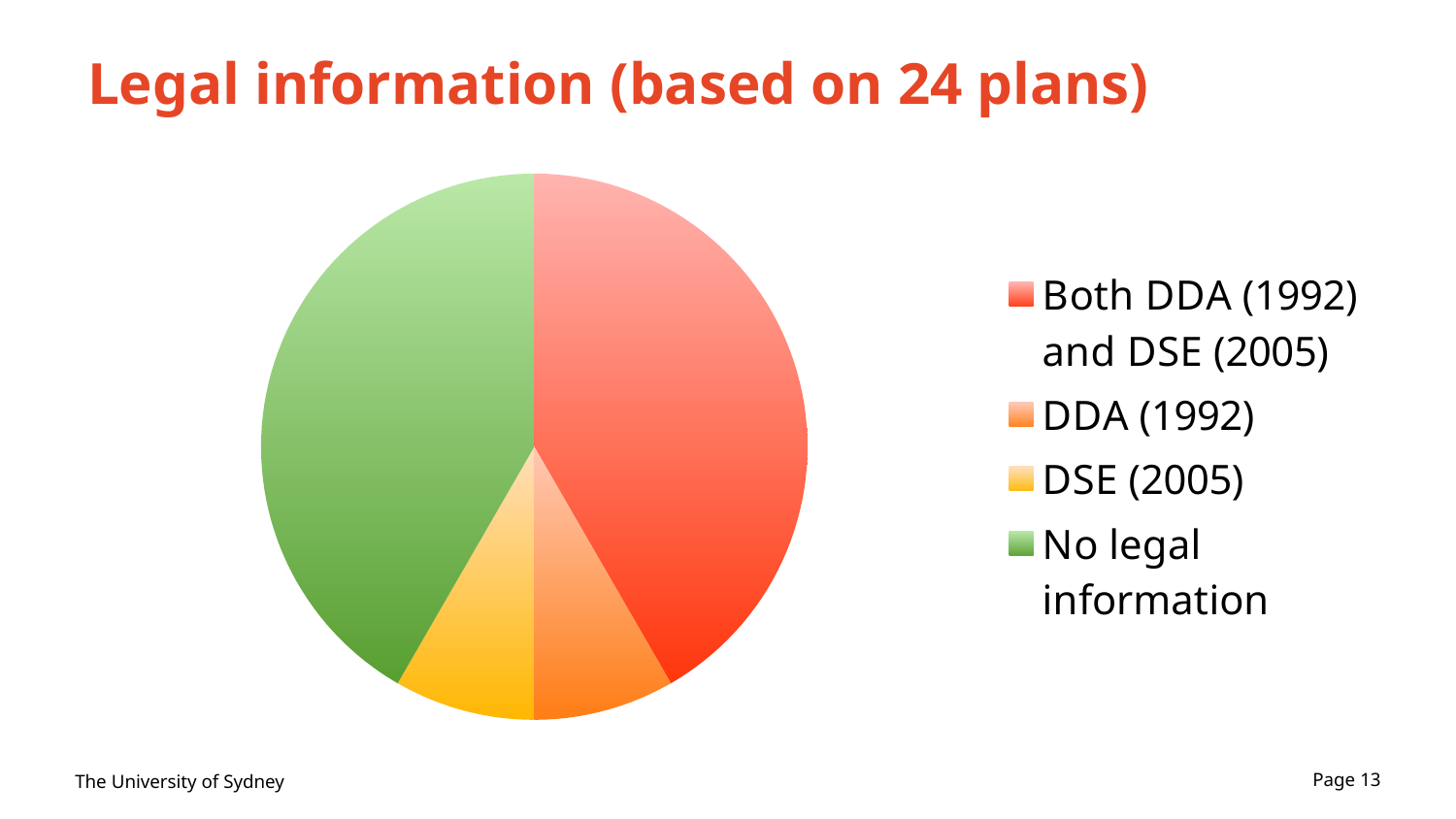
What kind of chart is shown on the slide? pie chart Which slice is larger: 'Both DDA (1992) and DSE (2005)' or 'DDA (1992)'? Both DDA (1992) and DSE (2005) Which slice is larger: 'No legal information' or 'DSE (2005)'? No legal information Which slice is larger: 'DDA (1992)' or 'No legal information'? No legal information How many entries does the legend list? 4 What is the title of the slide containing the pie chart? Legal information (based on 24 plans) How many plans is the pie chart based on, according to the title? 24 How many slices does the pie chart have? 4 Which colour represents 'No legal information' in the pie chart? green